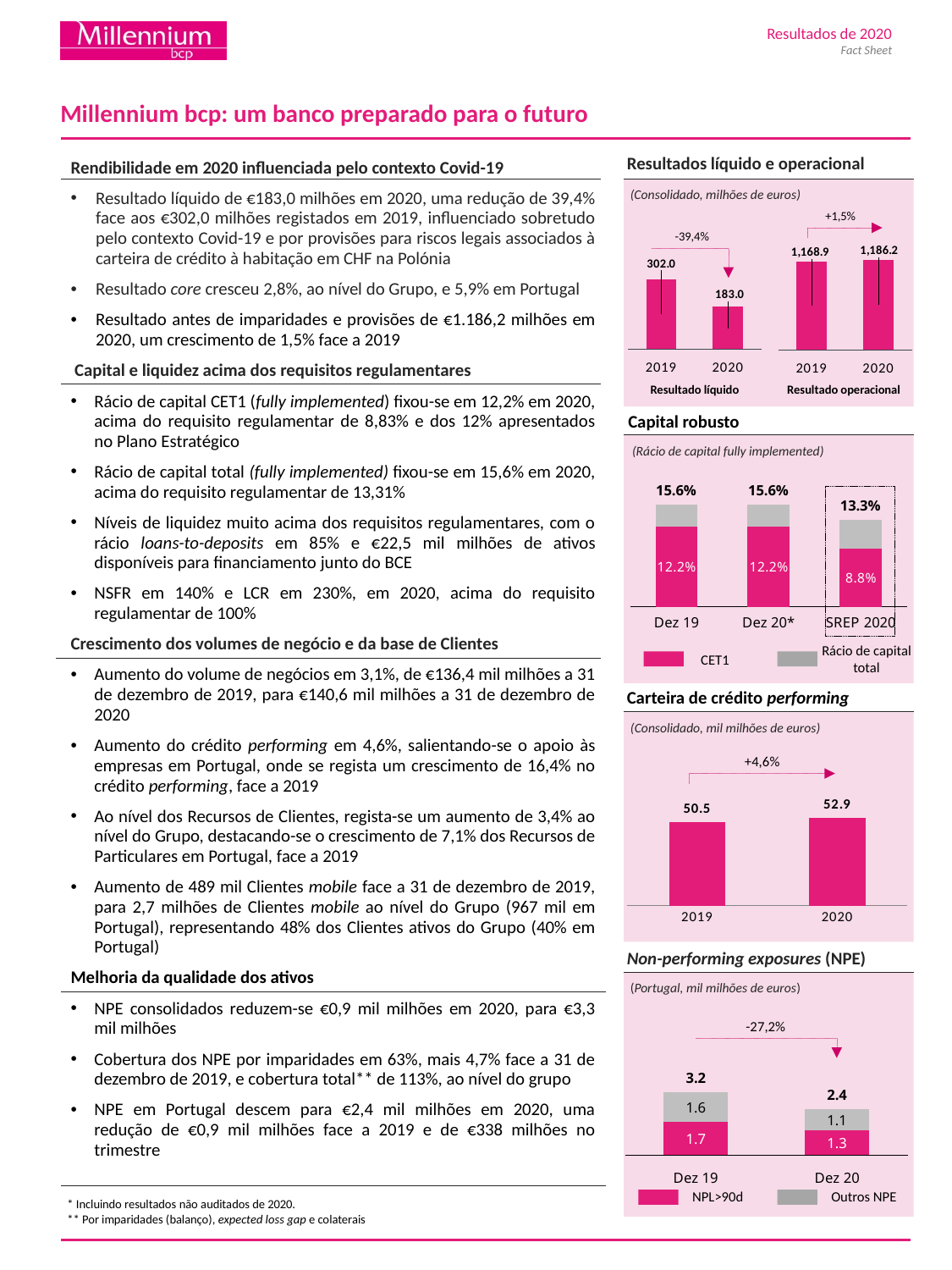
In the 'Capital robusto' chart, what is the CET1 ratio for Dez 20*? 12.2% In the 'Capital robusto' chart, which category has the lowest CET1 ratio? SREP 2020 In the 'Resultados líquido e operacional' chart, what percentage change is shown for Resultado operacional? +1,5% In the 'Resultados líquido e operacional' chart, what is the difference between the Resultado líquido values for 2019 and 2020? 119.0 In the 'Non-performing exposures (NPE)' chart, what is the total of the stacked bar for Dez 19? 3.2 In the 'Carteira de crédito performing' chart, what is the value for 2020? 52.9 In the 'Carteira de crédito performing' chart, what kind of chart is shown? Bar chart In the 'Resultados líquido e operacional' chart, what is the Resultado líquido value for 2020? 183.0 In the 'Capital robusto' chart, what is the total capital ratio shown for SREP 2020? 13.3% In the 'Resultados líquido e operacional' chart, what is the Resultado operacional value for 2019? 1,168.9 In the 'Non-performing exposures (NPE)' chart, what is the NPL>90d value for Dez 20? 1.3 In the 'Capital robusto' chart, how many series does the legend list? 2